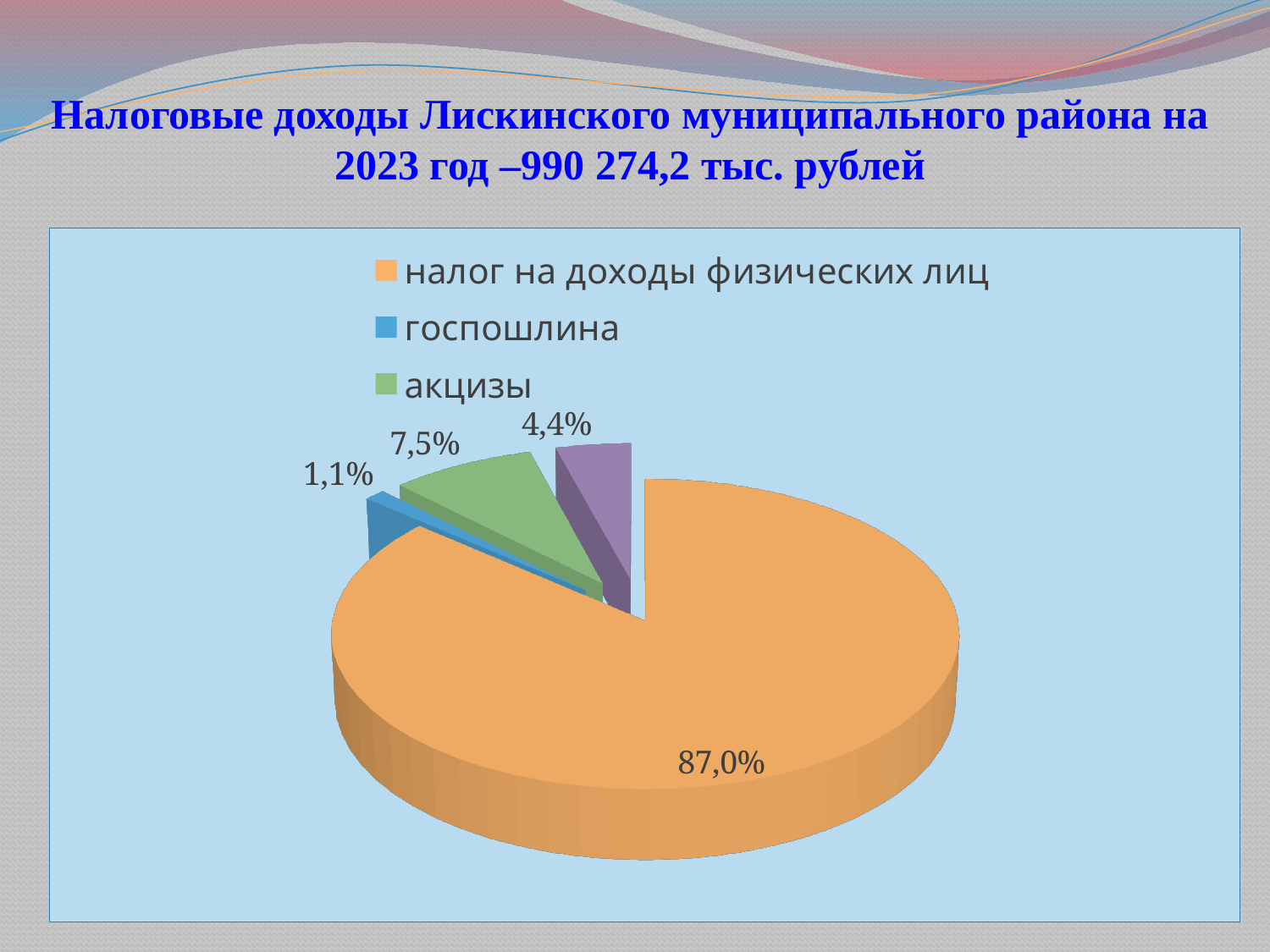
What is the difference in percentage points between the share for налог на доходы физических лиц and the share for акцизы? 79,5 What kind of chart is shown on the slide? pie chart How many entries does the legend list? 3 How many slices does the pie chart have? 4 According to the slide title, what is the total tax revenue of the Лискинский municipal district for 2023? 990 274,2 тыс. рублей Which is larger, the share for акцизы or the share for госпошлина? акцизы What share of the pie does налог на доходы физических лиц have? 87,0% Which category has the smallest slice of the pie? госпошлина Which category has the largest slice of the pie? налог на доходы физических лиц What share of the pie does госпошлина have? 1,1% What share of the pie does акцизы have? 7,5% What is the difference in percentage points between the share for акцизы and the share for госпошлина? 6,4